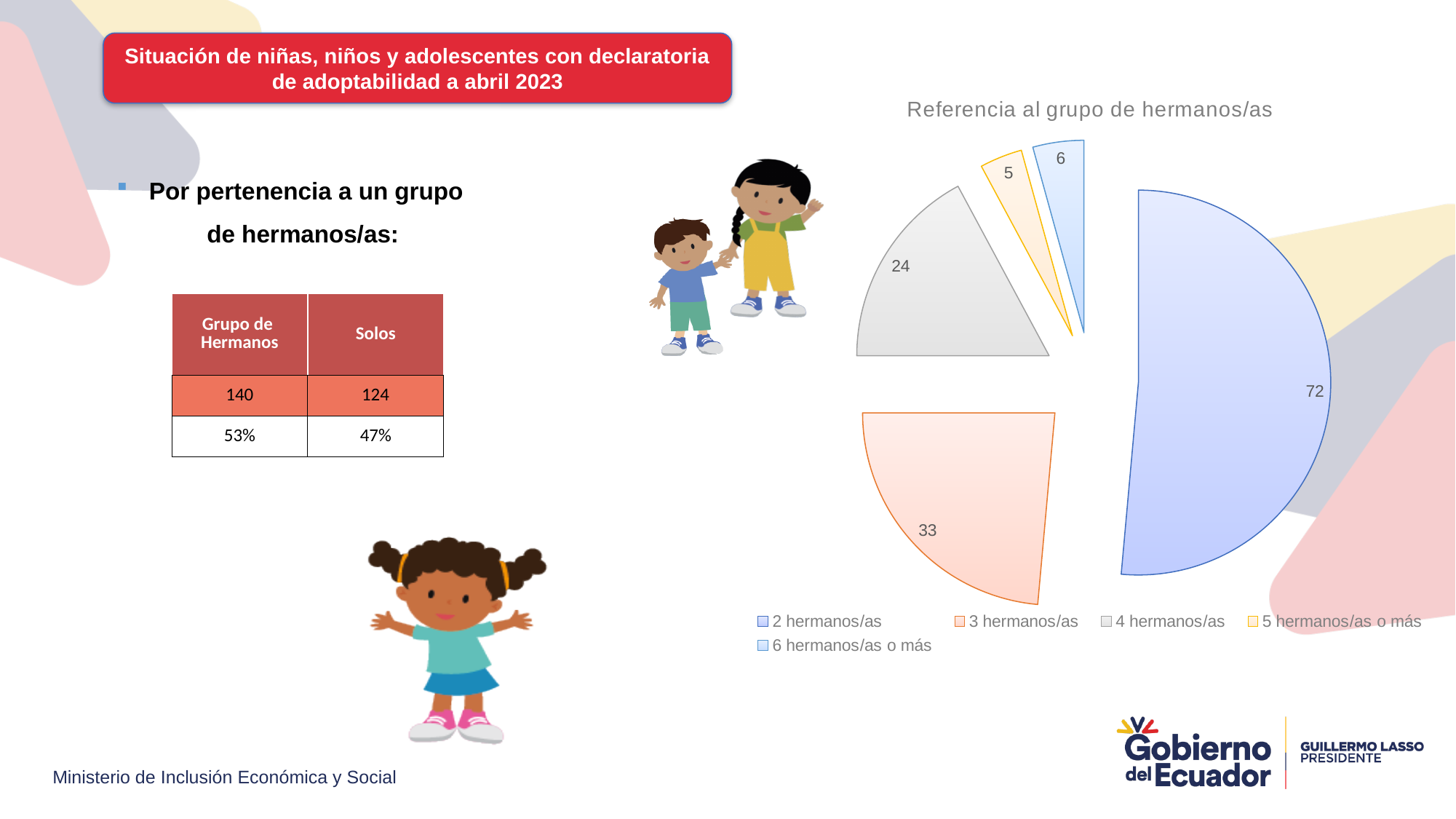
In the pie chart, what is the value for "2 hermanos/as"? 72 In the pie chart, which is larger: "4 hermanos/as" or "3 hermanos/as"? 3 hermanos/as In the pie chart, what is the value for "3 hermanos/as"? 33 Which category has the smallest slice in the pie chart? 5 hermanos/as o más In the pie chart, what is the value for "6 hermanos/as o más"? 6 How many categories does the pie chart legend list? 5 In the pie chart, what is the value for "4 hermanos/as"? 24 What type of chart is shown under the title "Referencia al grupo de hermanos/as"? Pie chart Which category has the largest slice in the pie chart? 2 hermanos/as What is the title of the pie chart? Referencia al grupo de hermanos/as What is the difference between the values for "2 hermanos/as" and "3 hermanos/as" in the pie chart? 39 What is the sum of all the slice values in the pie chart? 140